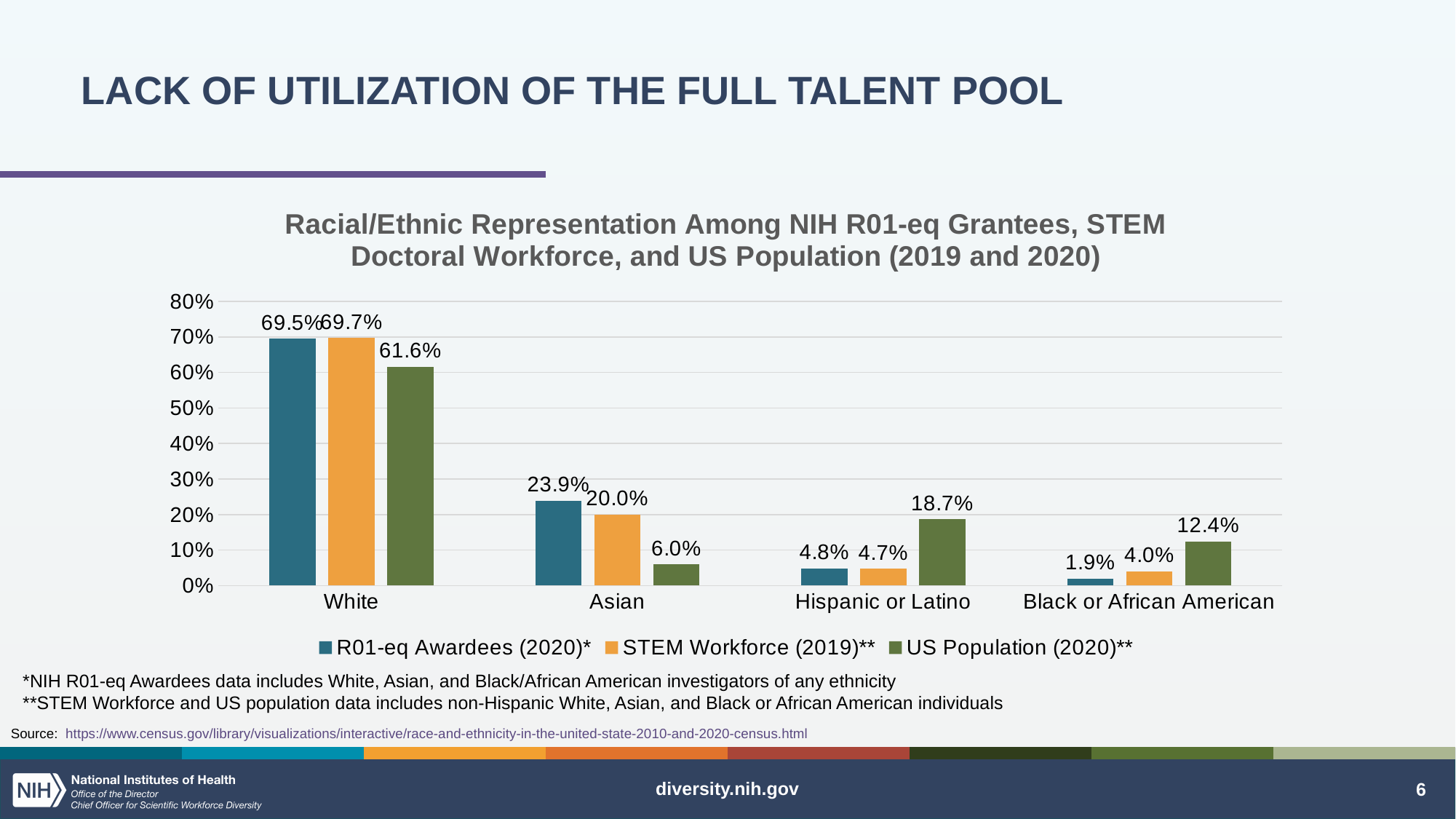
How many categories are shown on the x axis? 4 What is the difference between the STEM Workforce (2019) value and the US Population (2020) value for White? 8.1% What kind of chart is shown on the slide? Bar chart Which category has the highest US Population (2020) value? White What is the US Population (2020) value for Hispanic or Latino? 18.7% For Asian, which is larger: the R01-eq Awardees (2020) value or the US Population (2020) value? R01-eq Awardees (2020) What is the difference between the US Population (2020) value and the R01-eq Awardees (2020) value for Black or African American? 10.5% What is the R01-eq Awardees (2020) value for Asian? 23.9% Which category has the lowest R01-eq Awardees (2020) value? Black or African American What is the STEM Workforce (2019) value for Black or African American? 4.0% Which series is shown in green in the legend? US Population (2020)** How many series does the legend list? 3